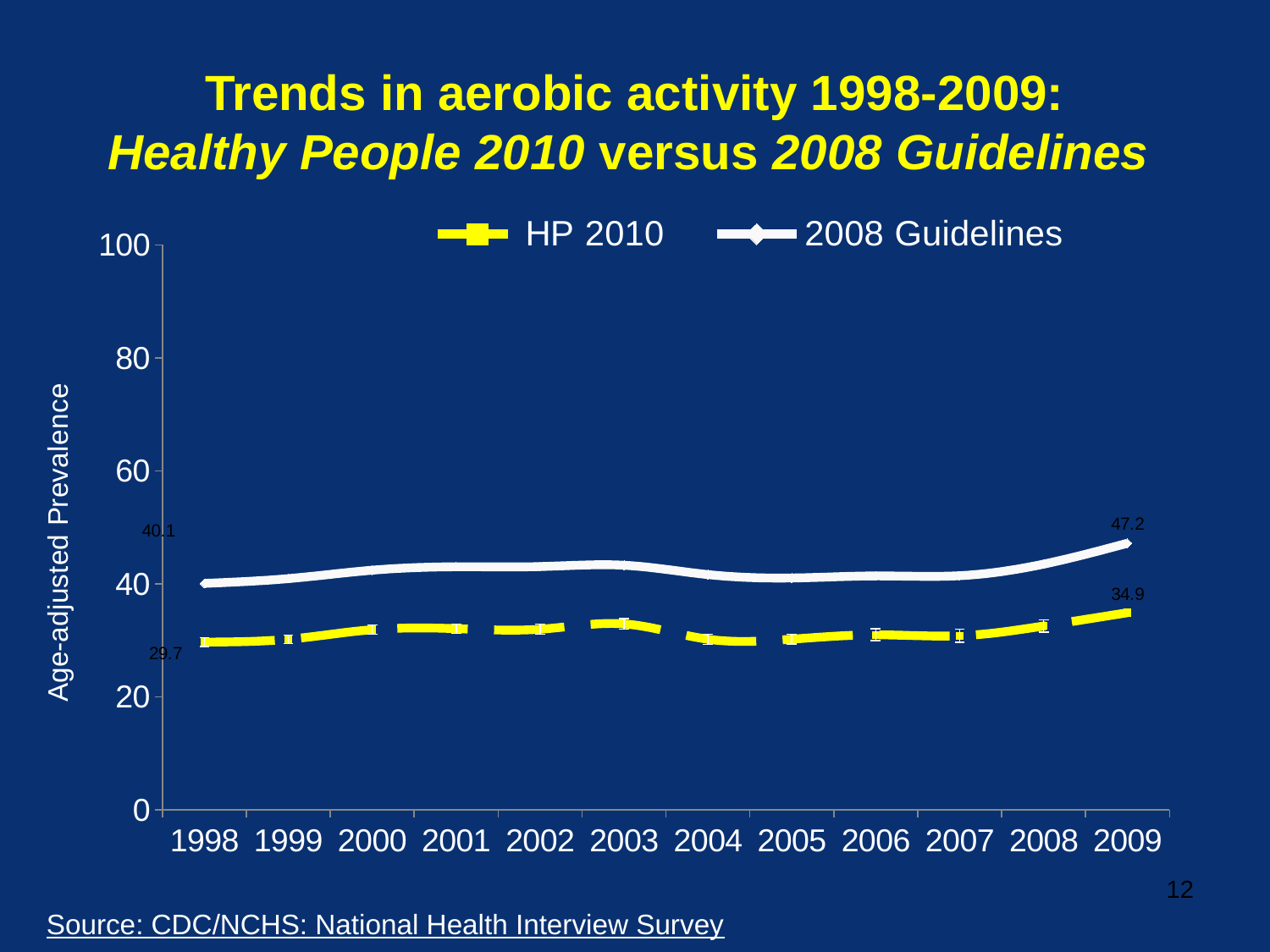
How many series does the legend list? 2 What is the value for HP 2010 in 1998? 29.7 What is the difference between the 2008 Guidelines and HP 2010 values in 2009? 12.3 What kind of chart is shown on the slide? line chart What is the value for HP 2010 in 2009? 34.9 Is the value for HP 2010 in 2003 greater or less than 40? less What is the value for 2008 Guidelines in 1998? 40.1 Is the value for 2008 Guidelines in 2003 greater or less than 40? greater What is the difference between the 2008 Guidelines values in 2009 and 1998? 7.1 Which series has the higher value in 2005, HP 2010 or 2008 Guidelines? 2008 Guidelines What is the value for 2008 Guidelines in 2009? 47.2 How many years are shown on the x axis? 12